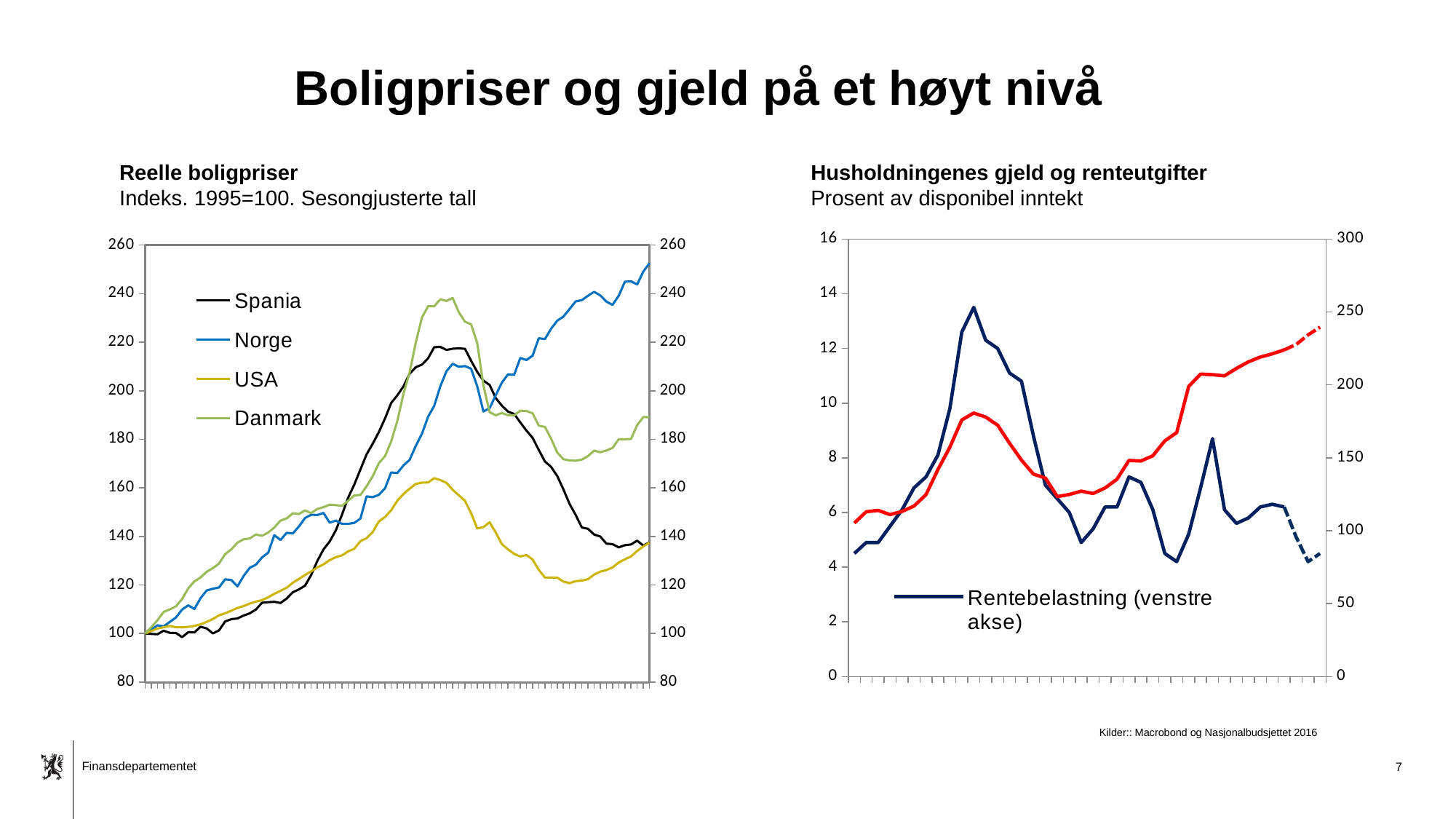
In the 'Reelle boligpriser' chart, does the Norge line overall rise or fall from left to right? Rise In the 'Husholdningenes gjeld og renteutgifter' chart, is the peak value of Rentebelastning (venstre akse) greater or less than 12? greater In the 'Reelle boligpriser' chart, is the final value for Norge greater or less than 240? greater What kind of chart is the 'Reelle boligpriser' chart? Line chart How many series does the legend of the 'Reelle boligpriser' chart list? 4 In the 'Husholdningenes gjeld og renteutgifter' chart, is the final value of Rentebelastning (venstre akse) greater or less than 6? less In the 'Reelle boligpriser' chart, which series has the highest value at the right end of the chart? Norge In the 'Reelle boligpriser' chart, what colour is the line for Norge? Blue What kind of chart is the 'Husholdningenes gjeld og renteutgifter' chart? Line chart How many series does the legend of the 'Husholdningenes gjeld og renteutgifter' chart list? 1